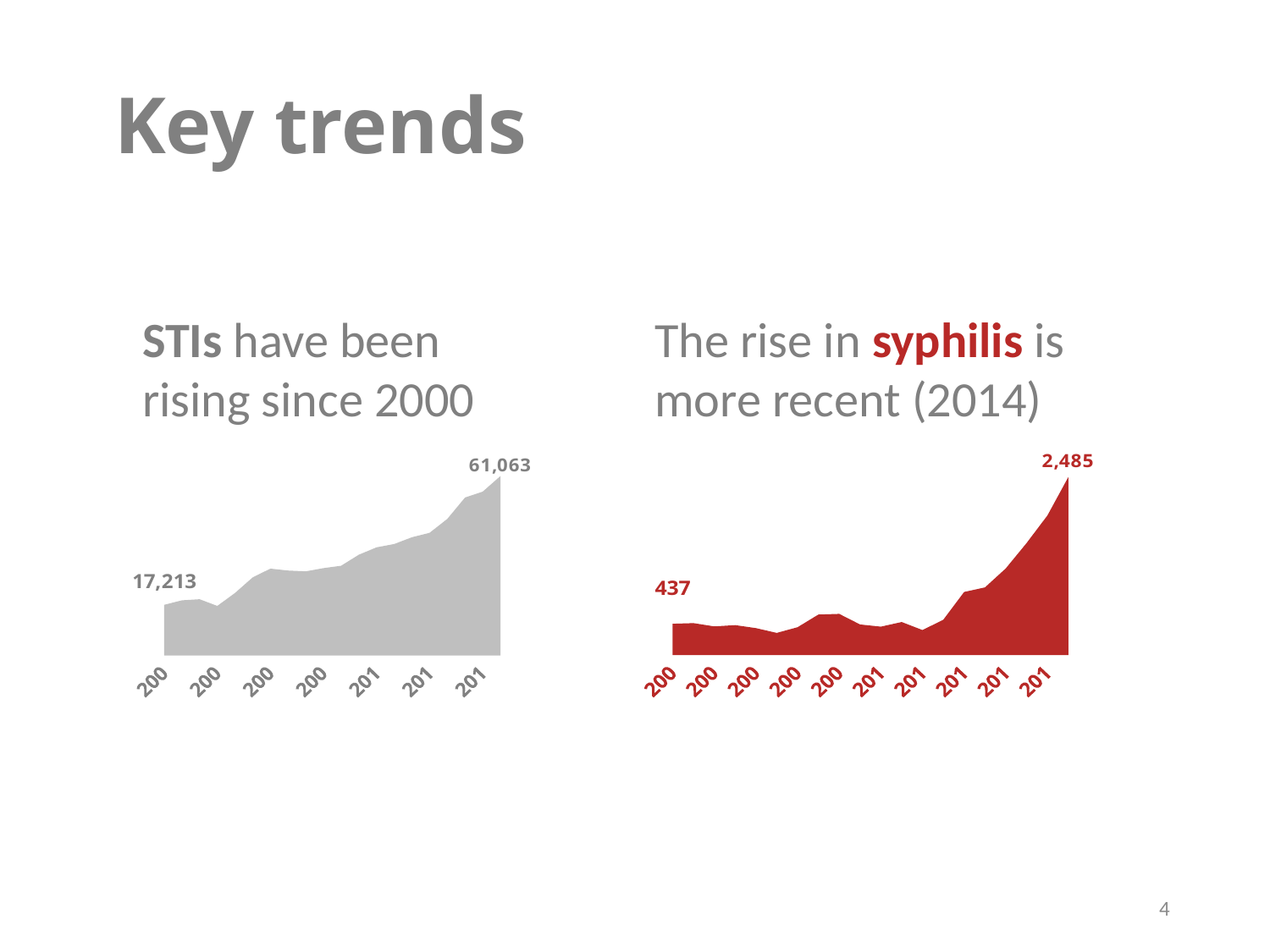
In the syphilis chart on the right, do the values overall rise or fall along the x axis? Rise In the STIs chart on the left, what is the difference between the last labelled value and the first labelled value? 43,850 In the syphilis chart on the right, what is the value labelled at the end of the series? 2,485 In the STIs chart on the left, what is the value labelled at the end of the series? 61,063 How many x-axis labels are shown on the syphilis chart on the right? 10 In the STIs chart on the left, what is the value labelled at the start of the series? 17,213 In the syphilis chart on the right, what is the value labelled at the start of the series? 437 Which is larger: the final labelled value in the STIs chart (61,063) or the final labelled value in the syphilis chart (2,485)? STIs chart (61,063) In the STIs chart on the left, is the highest value at the start or the end of the series? End What colour is the filled area in the syphilis chart on the right? Red In the syphilis chart on the right, what is the difference between the last labelled value and the first labelled value? 2,048 What kind of chart is the STIs chart on the left? Area chart